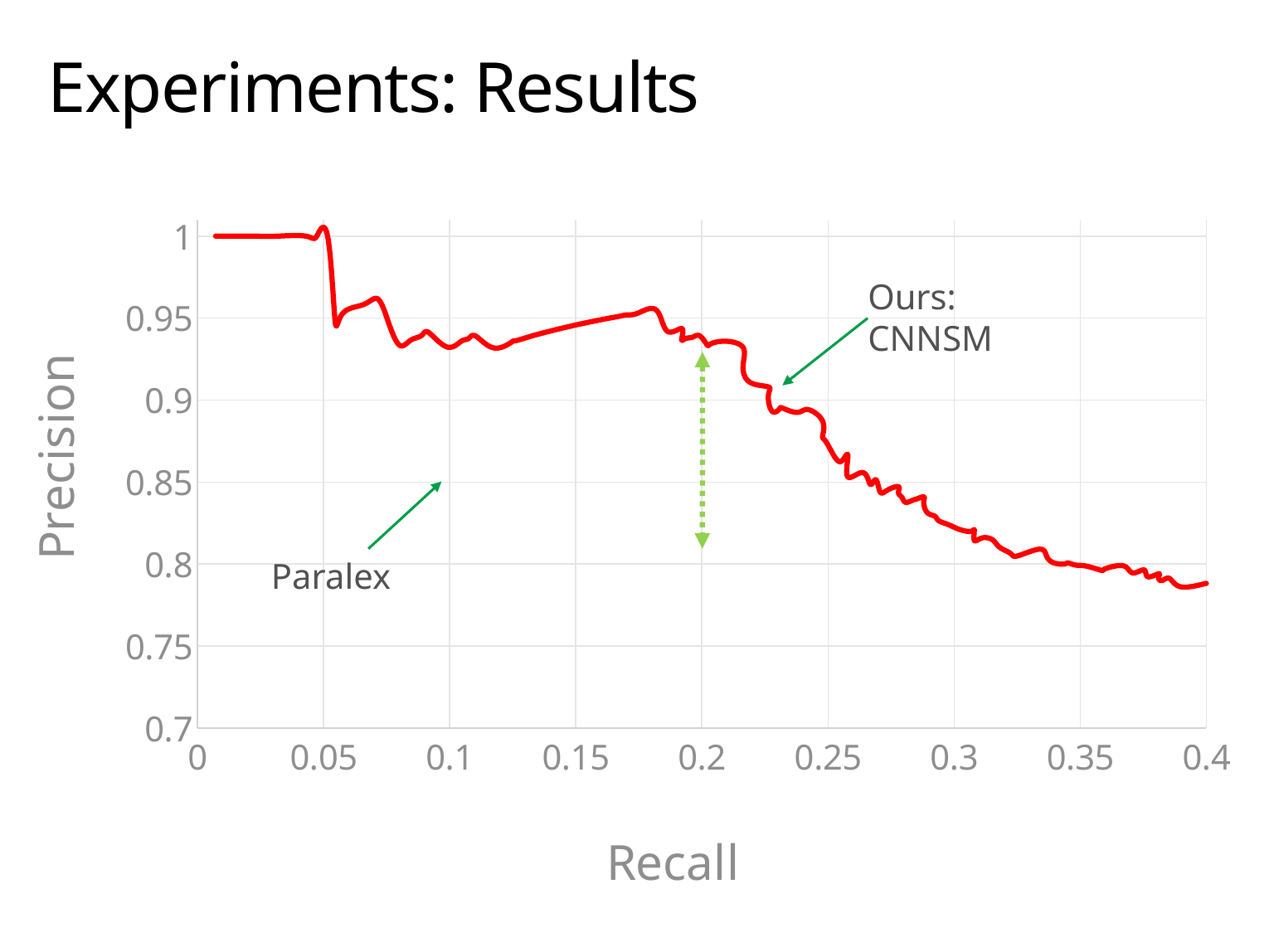
What is the label of the x axis? Recall Is the precision at recall 0.4 greater or less than 0.8? less What is the label of the y axis? Precision What kind of chart is shown on the slide? line chart Is the precision at recall 0.1 greater or less than 0.9? greater What method name is annotated as 'Ours' on the chart? CNNSM Is the precision at recall 0.2 greater or less than 0.9? greater Does precision generally rise or fall as recall increases from 0 to 0.4? fall What is the precision of the curve at the lowest recall values (near recall 0)? 1 Is the precision higher at recall 0.15 or at recall 0.35? 0.15